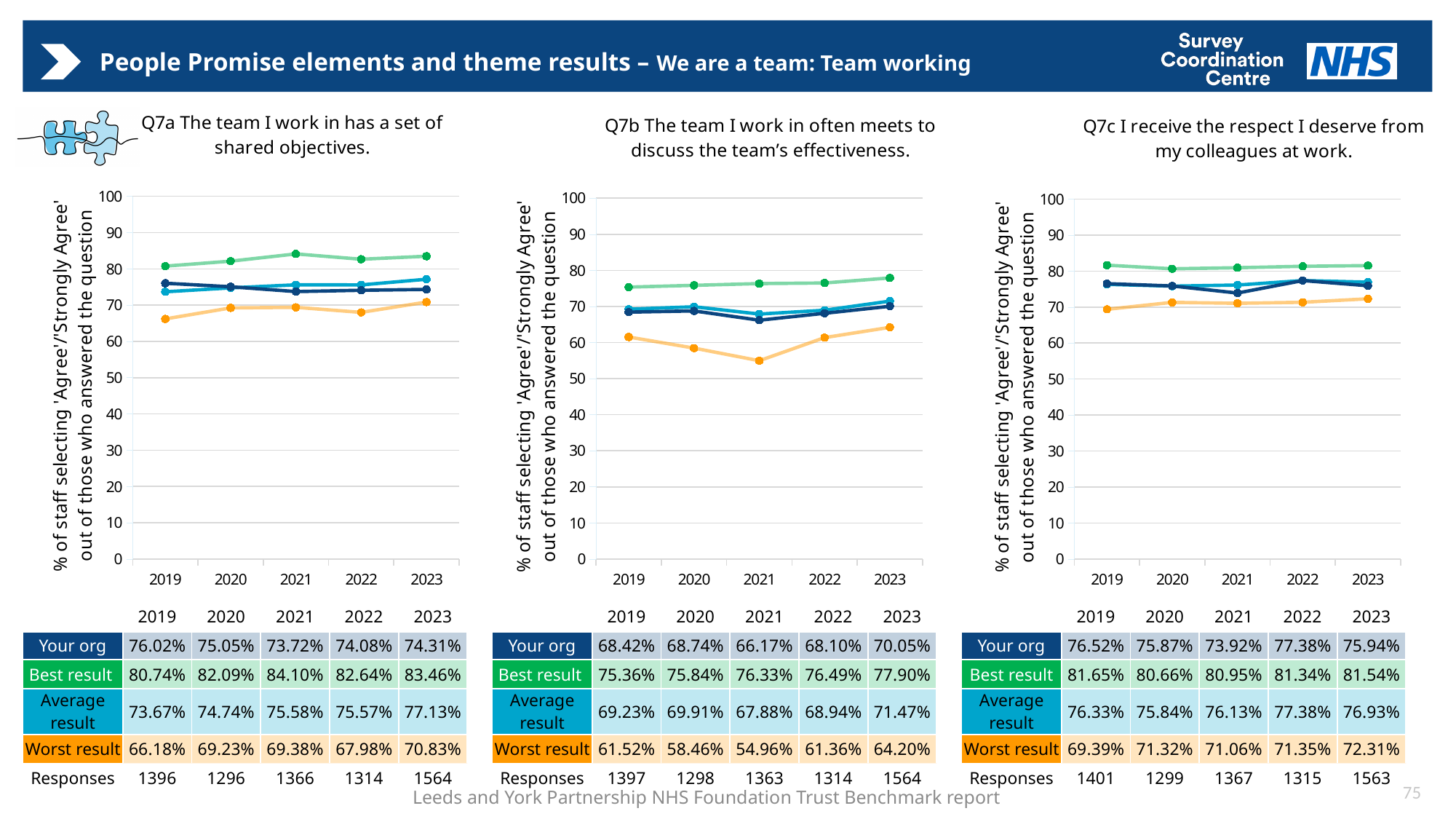
In the Q7a chart (The team I work in has a set of shared objectives), what is the value for Your org in 2023? 74.31% In the Q7c chart (I receive the respect I deserve from my colleagues at work), what is the Best result value in 2019? 81.65% In the Q7a chart, which year has the highest Best result value? 2021 How many years are plotted on the x axis of the Q7c chart? 5 In the Q7b chart (The team I work in often meets to discuss the team's effectiveness), what is the Worst result value in 2021? 54.96% In the Q7b chart, does the Best result line rise or fall from 2019 to 2023? Rise In the Q7b chart, which is larger in 2022: the Your org value or the Average result value? Average result In the Q7a chart, is the Worst result value for 2019 greater or less than 70? less In the Q7c chart, what is the difference between the Best result and Your org values in 2023? 5.60% What kind of chart is used for Q7a? Line chart How many series are plotted in the Q7b chart? 4 In the Q7b chart, which year has the lowest Your org value? 2021